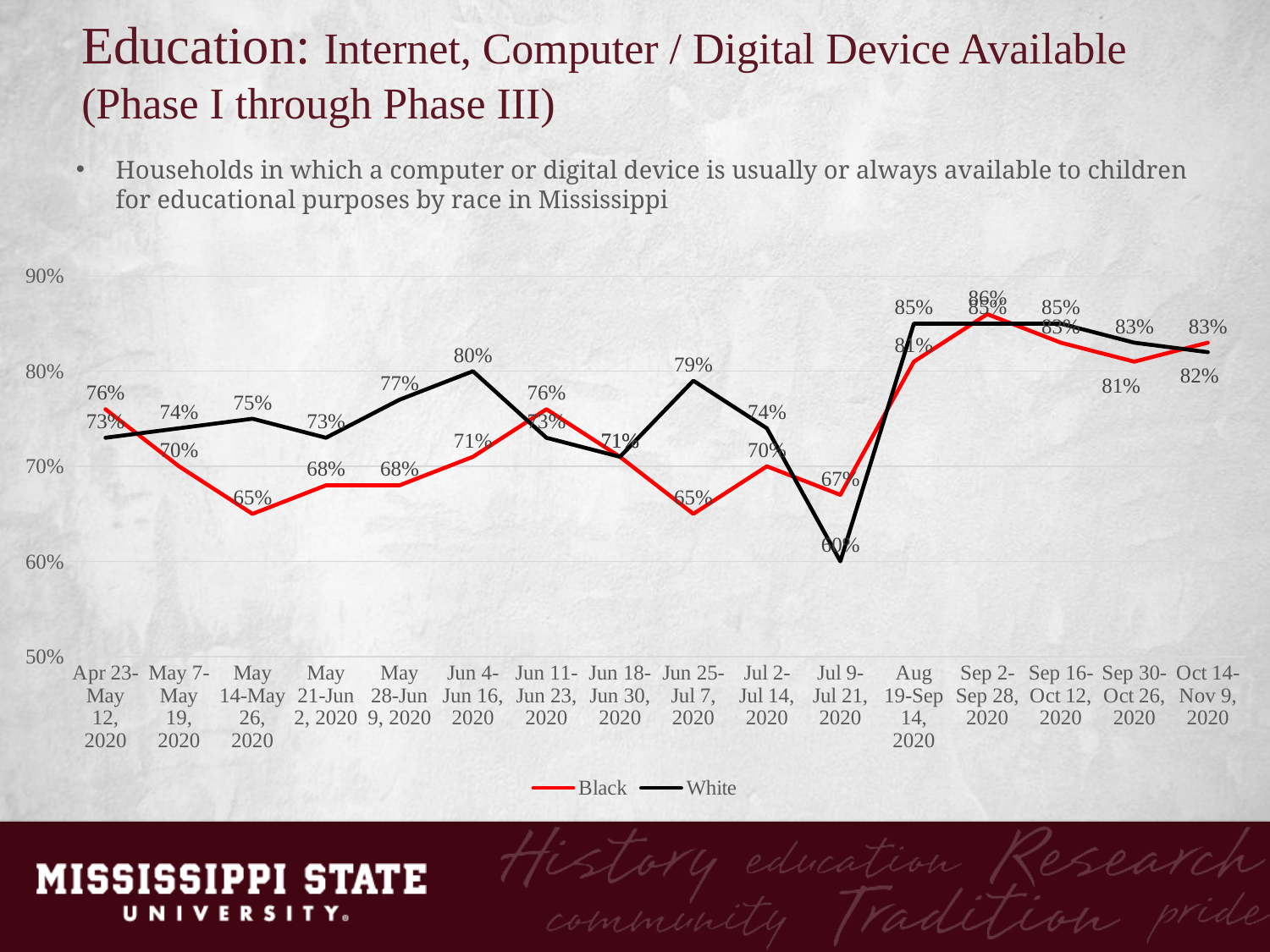
What is the value for Black in the Oct 14-Nov 9, 2020 period? 83% What is the value for White in the Jun 4-Jun 16, 2020 period? 80% What kind of chart is shown on the slide? Line chart What is the value for White in the Jul 9-Jul 21, 2020 period? 60% How many series does the legend list? 2 What is the difference between the Black and White values in the Apr 23-May 12, 2020 period? 3 percentage points How many time periods are shown along the x axis? 16 What is the value for Black in the Apr 23-May 12, 2020 period? 76% In the Jun 25-Jul 7, 2020 period, which series has the higher value, Black or White? White In which period is the White series at its lowest value? Jul 9-Jul 21, 2020 What is the difference between the Black and White values in the Jul 9-Jul 21, 2020 period? 7 percentage points Which colour is used for the Black series line? Red